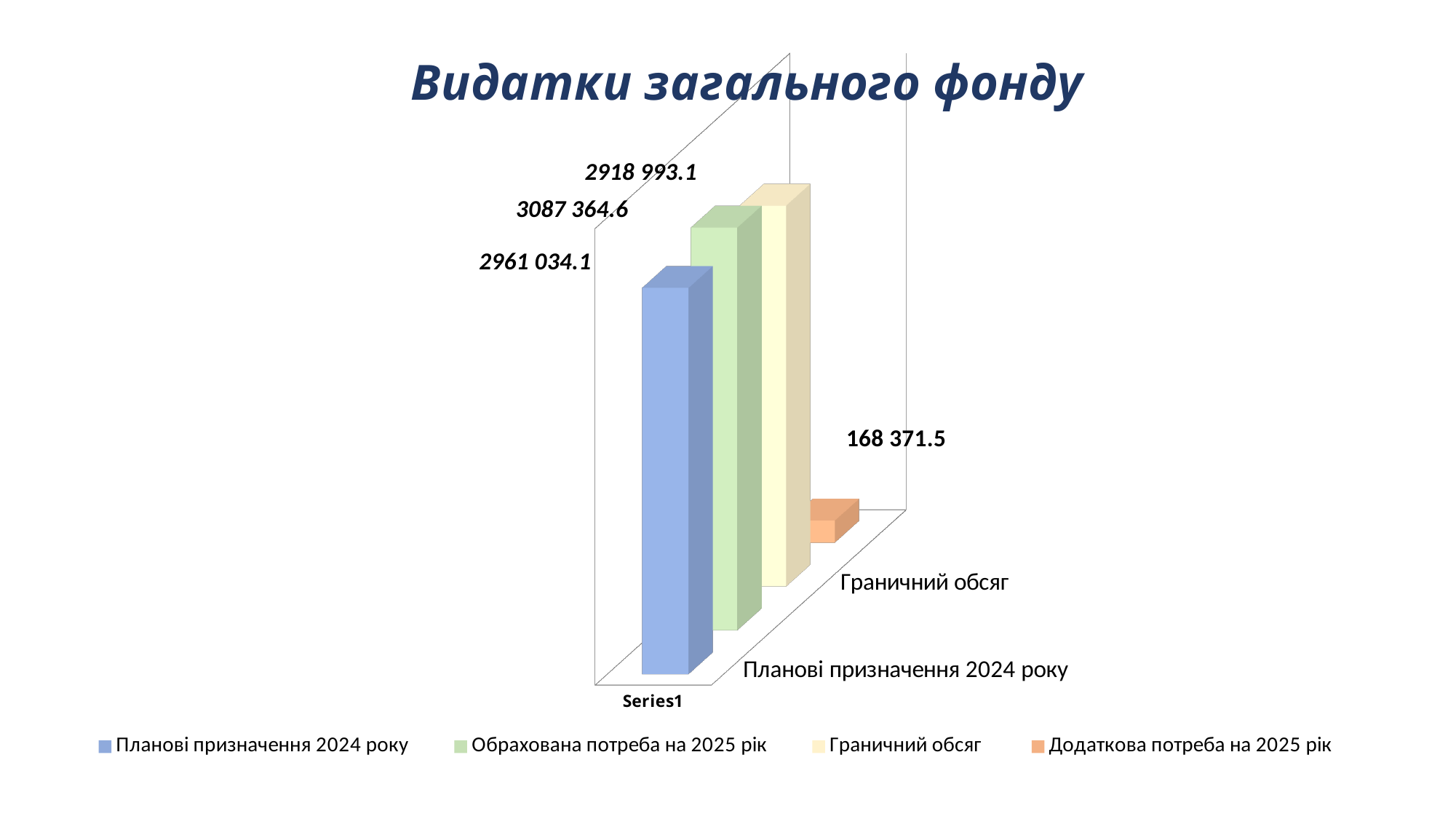
What is the value for Граничний обсяг? 2918 993.1 Which is larger, Обрахована потреба на 2025 рік or Граничний обсяг? Обрахована потреба на 2025 рік What is the difference between Обрахована потреба на 2025 рік and Планові призначення 2024 року? 126 330.5 Which series has the highest value? Обрахована потреба на 2025 рік What is the value for Обрахована потреба на 2025 рік? 3087 364.6 Which series has the lowest value? Додаткова потреба на 2025 рік What type of chart is shown on the slide? bar chart What is the value for Додаткова потреба на 2025 рік? 168 371.5 What is the difference between Обрахована потреба на 2025 рік and Граничний обсяг? 168 371.5 What is the value for Планові призначення 2024 року? 2961 034.1 What is the title of the chart? Видатки загального фонду How many series does the legend list? 4